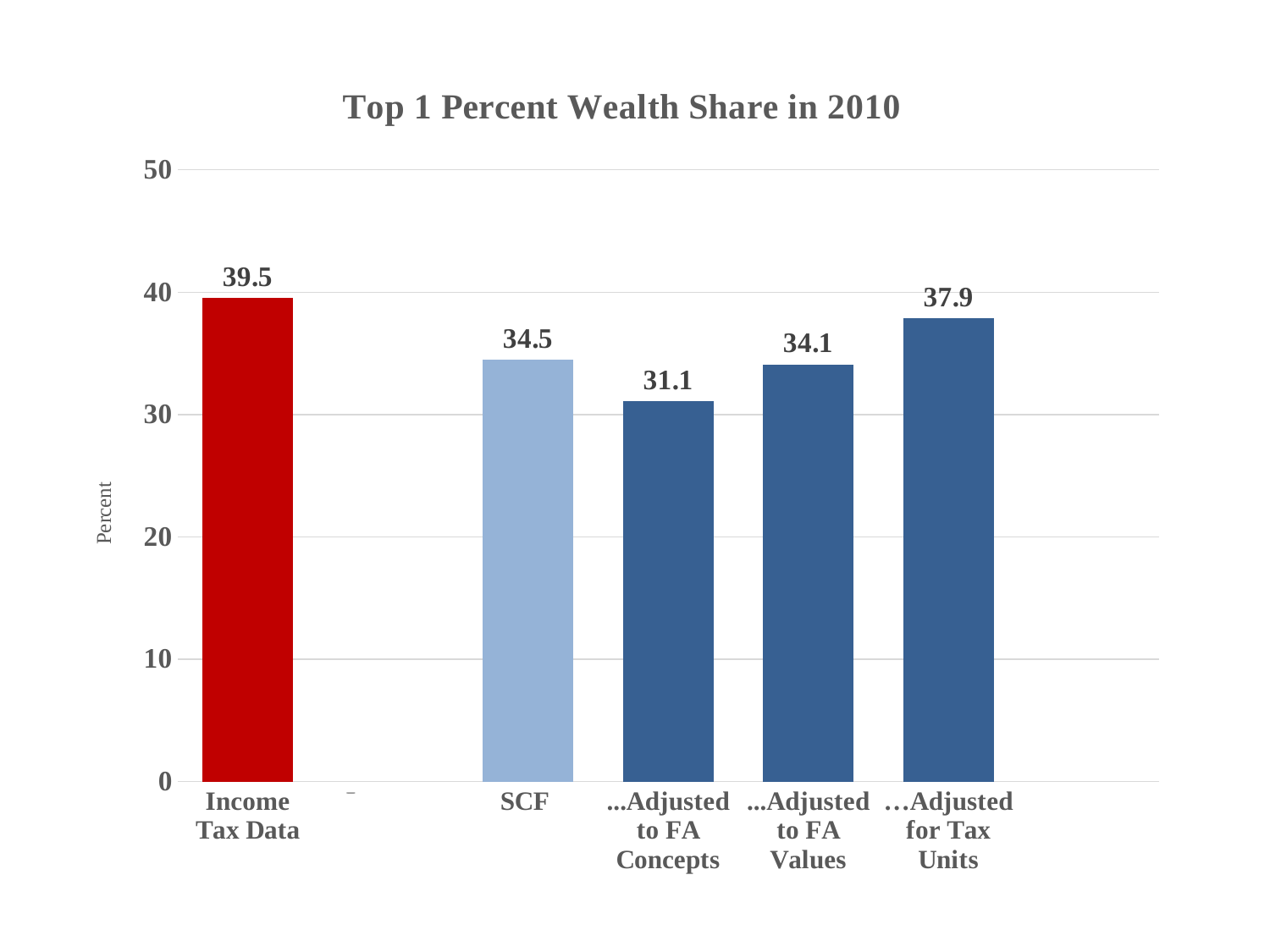
What kind of chart is shown? bar chart What is the value for ...Adjusted to FA Concepts? 31.1 How many bars are plotted on the chart? 5 Which is larger, the value for SCF or the value for ...Adjusted to FA Values? SCF What is the value for ...Adjusted for Tax Units? 37.9 Which category has the highest value? Income Tax Data What is the value for SCF? 34.5 What is the title of the chart? Top 1 Percent Wealth Share in 2010 What is the difference between the values for ...Adjusted for Tax Units and ...Adjusted to FA Values? 3.8 What is the value for Income Tax Data? 39.5 Which category has the lowest value? ...Adjusted to FA Concepts What is the difference between the values for Income Tax Data and SCF? 5.0